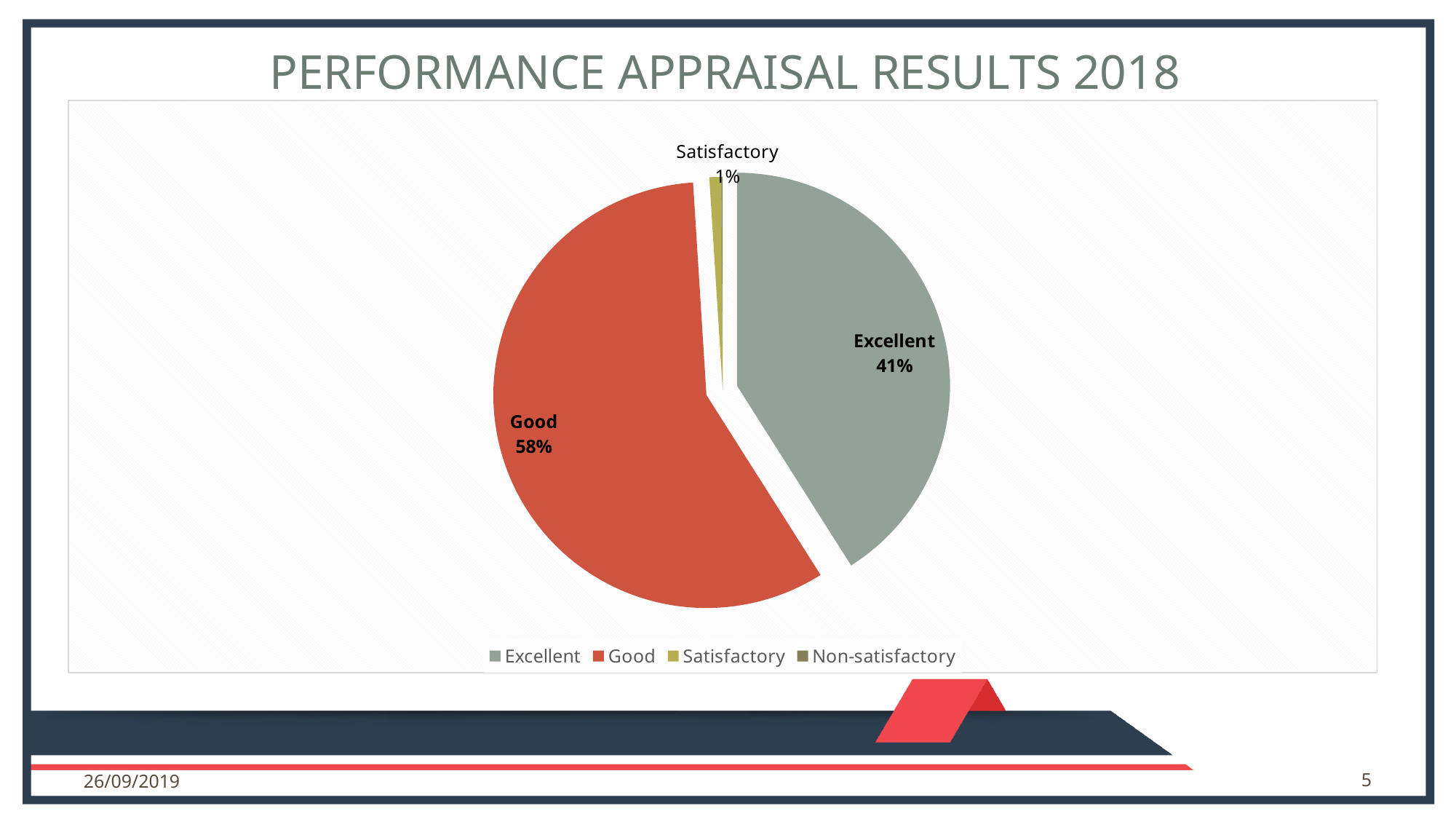
Which is larger, the Excellent share or the Good share? Good Which labelled slice has the smallest share of the pie? Satisfactory What is the title of the chart? PERFORMANCE APPRAISAL RESULTS 2018 What percentage of appraisals were rated Satisfactory? 1% What is the difference in percentage points between the Good and Excellent shares? 17 How many categories does the legend list? 4 Which rating category has the largest share of the pie? Good What percentage of appraisals were rated Excellent? 41% What is the combined share of the Excellent and Good slices? 99% What percentage of appraisals were rated Good? 58% What kind of chart is shown on the slide? pie chart What colour is the Good slice? red